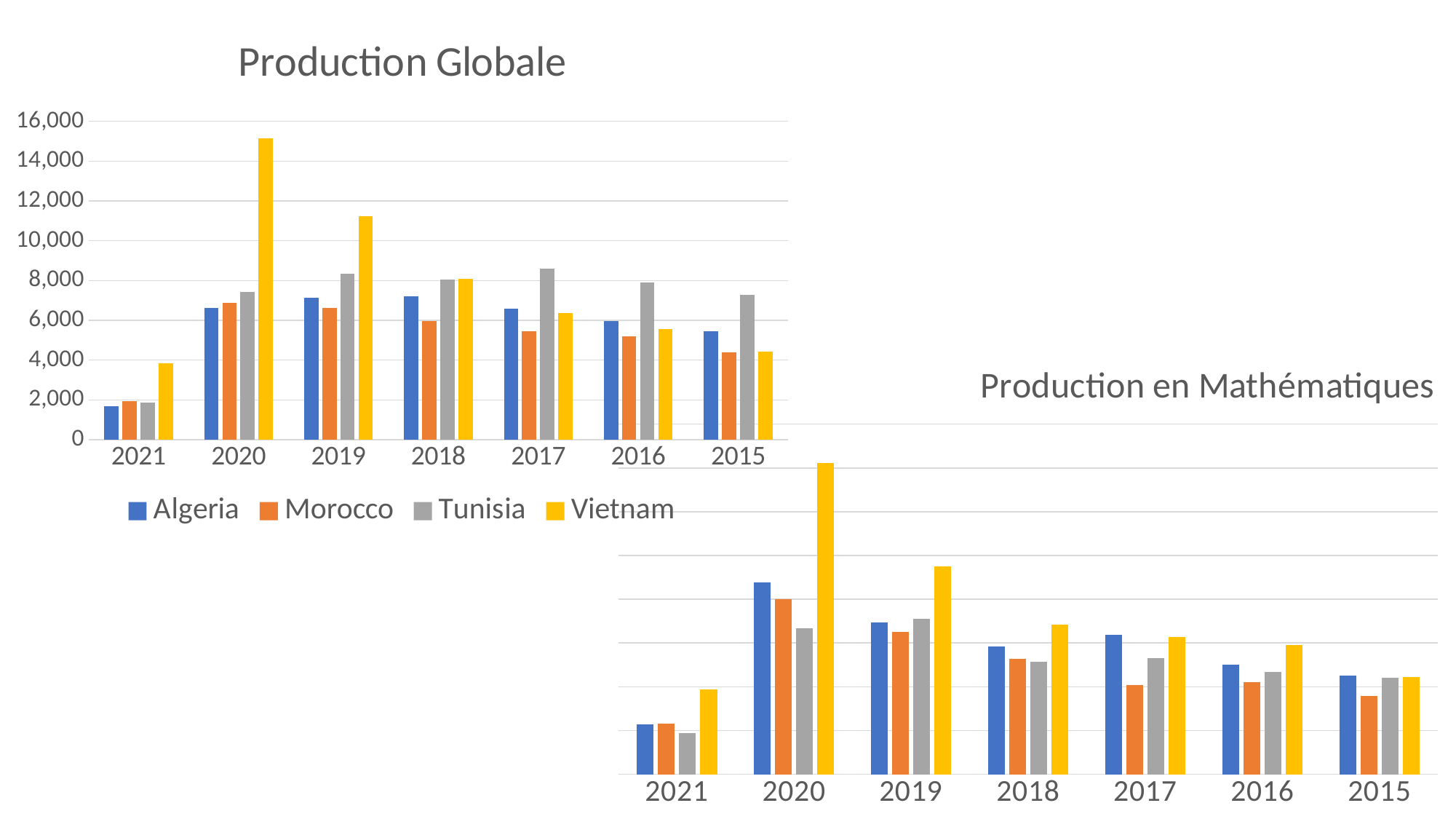
In the Production Globale chart, which country has the tallest bar in 2020? Vietnam In the Production Globale chart, which country has the lowest bar in 2021? Algeria How many years are shown on the x axis of the Production Globale chart? 7 In the Production Globale chart, is the value for Vietnam in 2019 greater or less than 10,000? greater What kind of chart is the Production en Mathématiques chart? bar chart How many series does the legend of the Production Globale chart list? 4 In the Production Globale chart, which is larger in 2017, Tunisia or Morocco? Tunisia In the Production en Mathématiques chart, which year has the tallest bar overall? 2020 In the Production en Mathématiques chart, which is larger in 2019, the yellow bar or the blue bar? the yellow bar In the Production Globale chart, is the value for Tunisia in 2017 greater or less than 8,000? greater In the Production Globale chart, is the value for Vietnam in 2020 greater or less than 14,000? greater